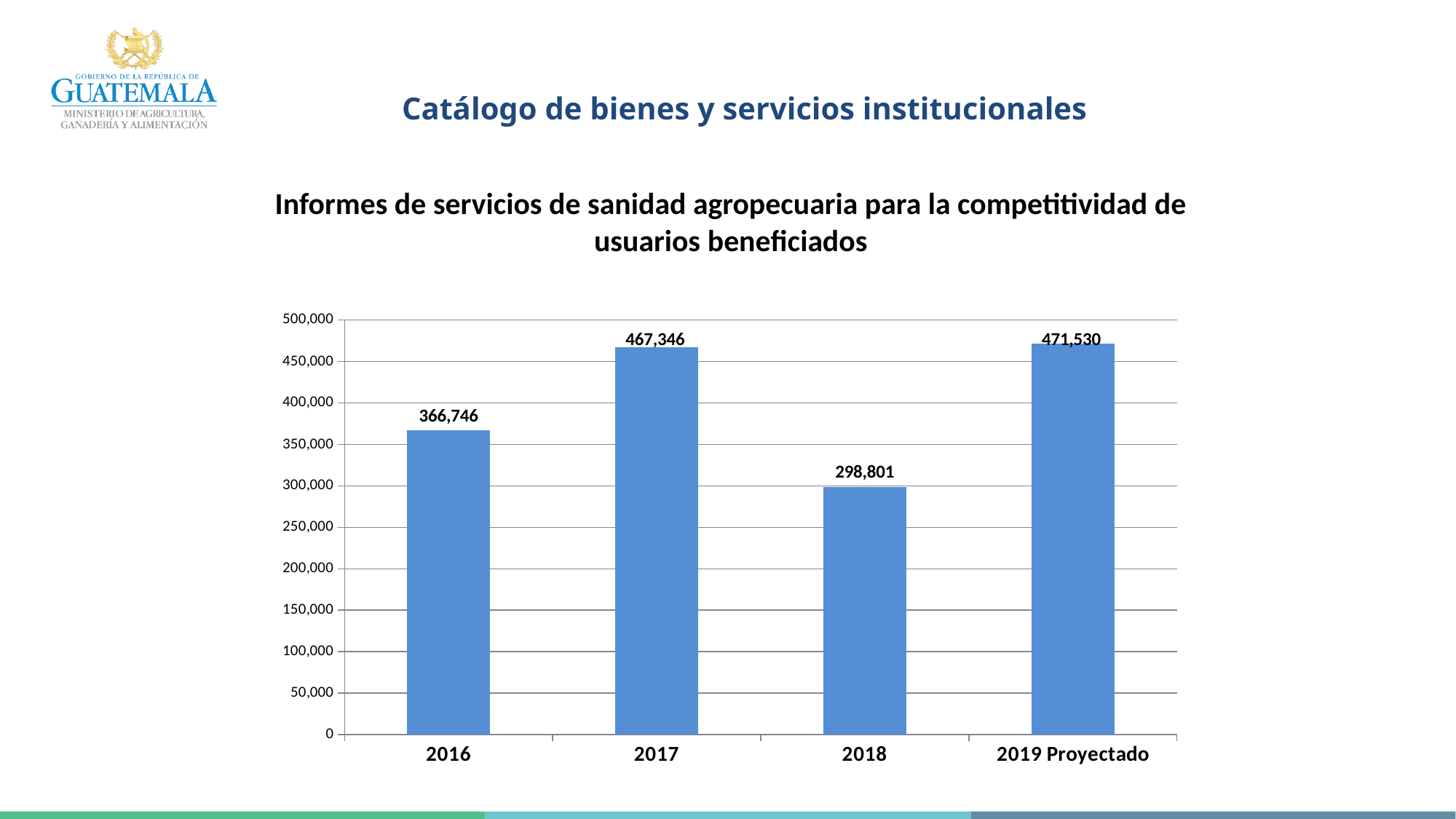
Is the value for 2016 greater or less than 350,000? greater How many categories are shown on the x axis? 4 Which is larger, the value for 2016 or the value for 2018? 2016 What is the value for 2016? 366,746 What is the difference between the values for 2019 Proyectado and 2018? 172,729 Which category has the lowest value? 2018 What is the value for 2019 Proyectado? 471,530 Which category has the highest value? 2019 Proyectado What kind of chart is shown on the slide? bar chart What is the difference between the values for 2017 and 2016? 100,600 What is the value for 2017? 467,346 What is the value for 2018? 298,801